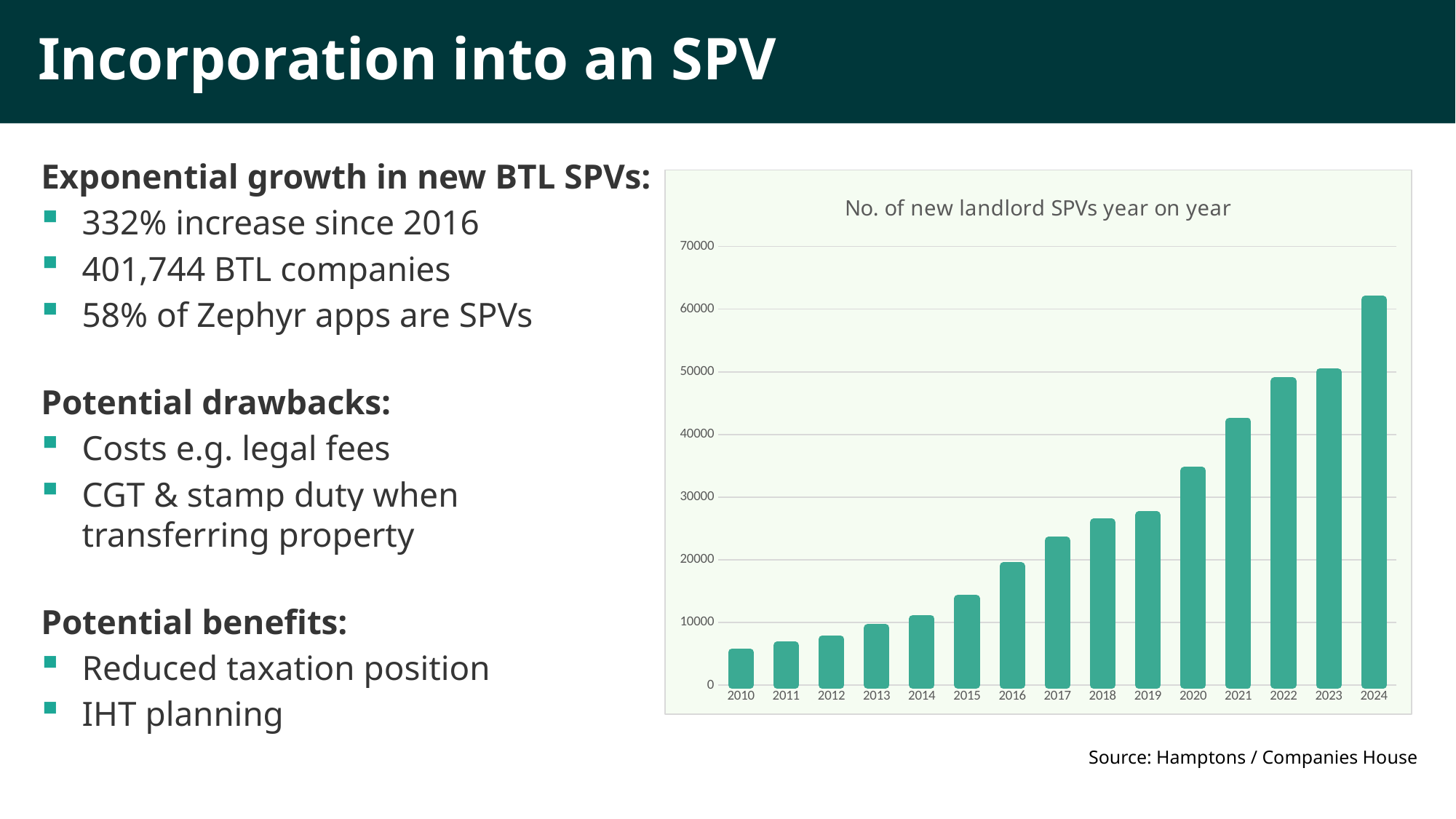
Do the values generally rise or fall from 2010 to 2024? Rise Is the value for 2010 greater or less than 10000? less Which year has the lowest number of new landlord SPVs? 2010 How many years are plotted on the chart? 15 Is the value for 2020 greater or less than 30000? greater Is the value for 2021 greater or less than 40000? greater What is the title of the chart? No. of new landlord SPVs year on year Which year has the highest number of new landlord SPVs? 2024 Which year has the larger value, 2017 or 2020? 2020 What kind of chart is shown on the slide? Bar chart